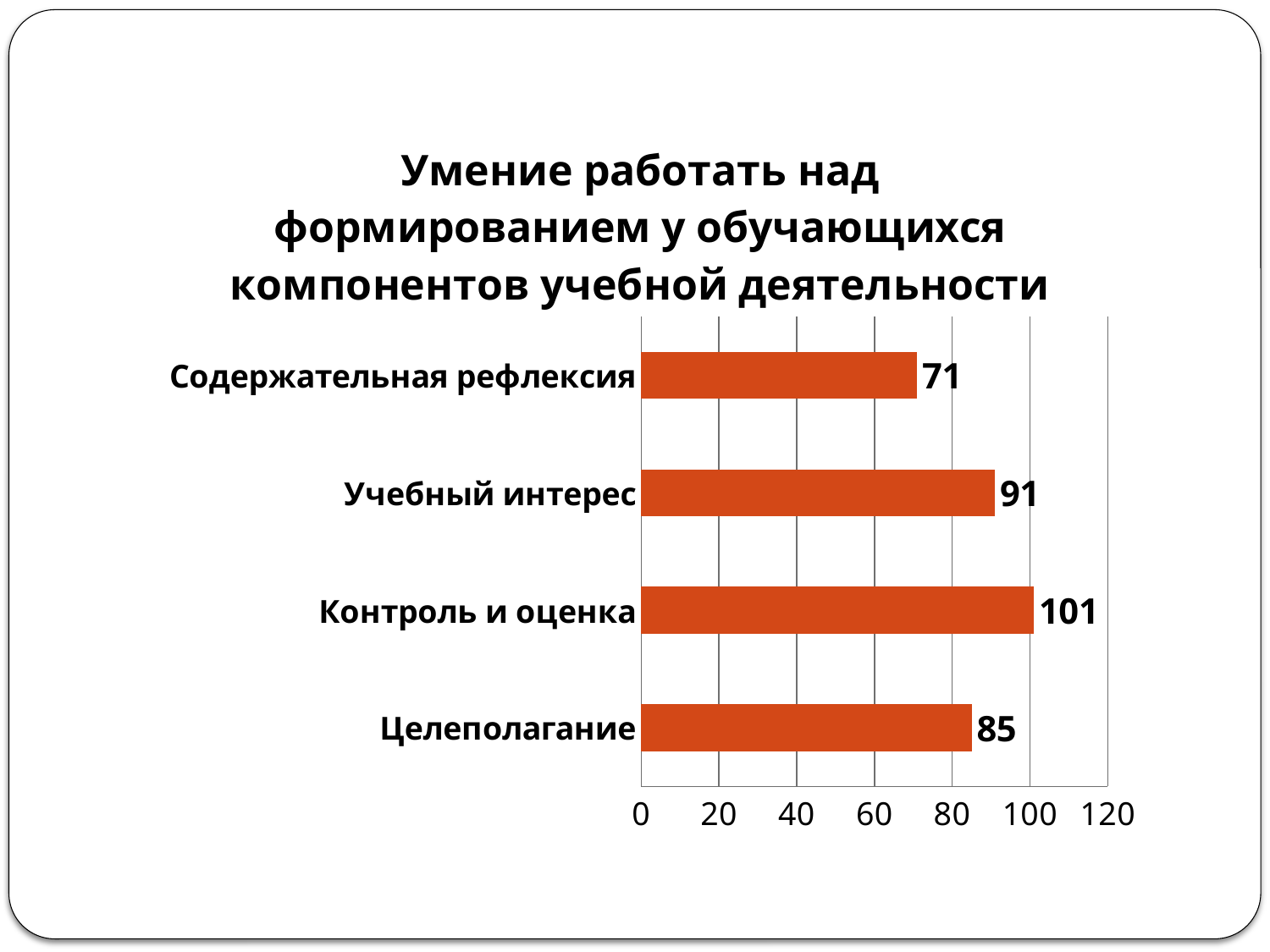
What is the value for Контроль и оценка? 101 What is the difference between the values for Учебный интерес and Целеполагание? 6 Which category has the highest value? Контроль и оценка What is the value for Содержательная рефлексия? 71 What is the value for Целеполагание? 85 How many categories are shown in the chart? 4 What kind of chart is shown on the slide? bar chart What is the value for Учебный интерес? 91 Is the value for Контроль и оценка greater or less than 100? greater What is the difference between the values for Контроль и оценка and Содержательная рефлексия? 30 Which is larger, the value for Учебный интерес or the value for Целеполагание? Учебный интерес Which category has the lowest value? Содержательная рефлексия